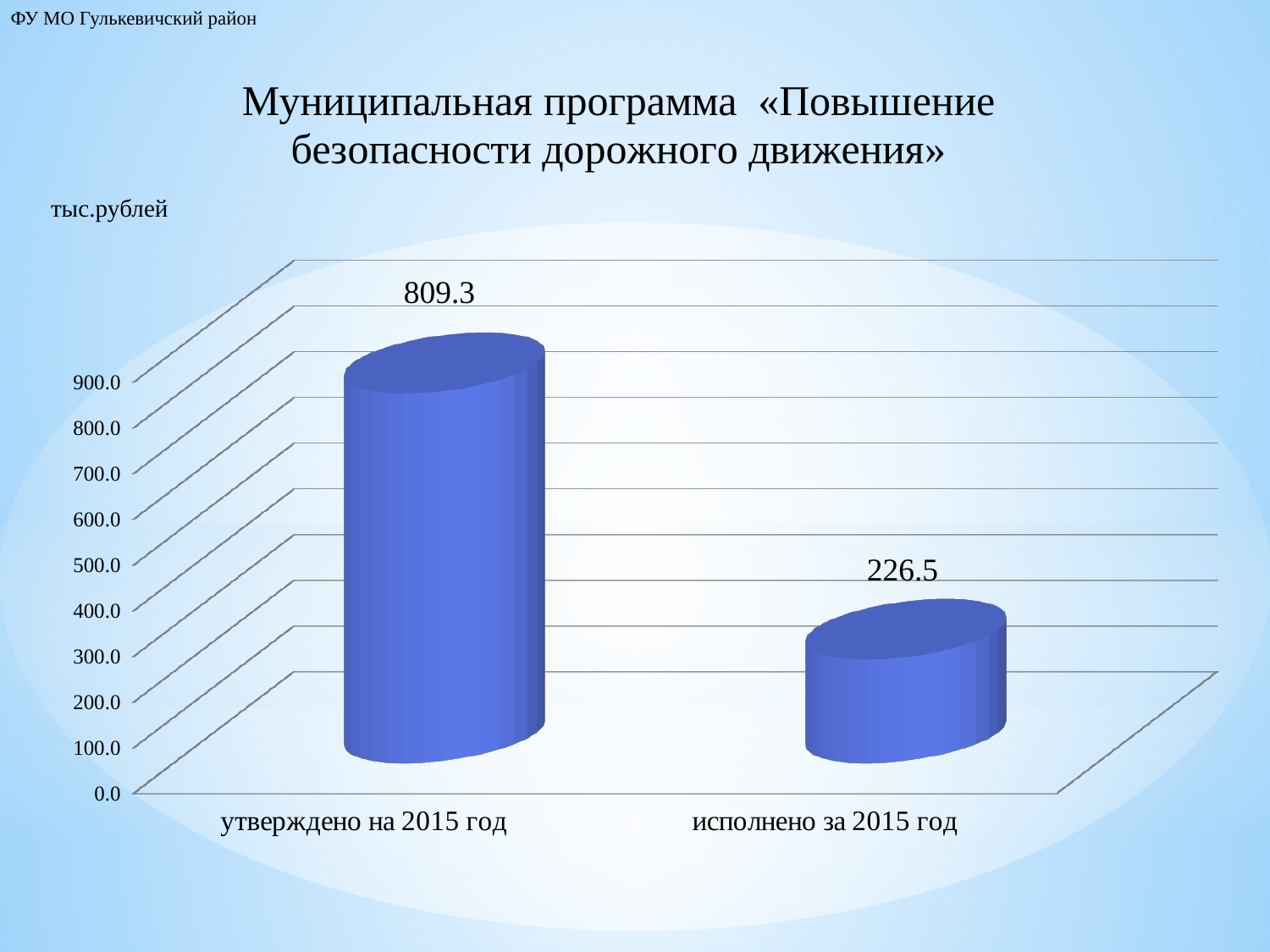
What is the highest value shown on the vertical axis? 900.0 What is the value for «исполнено за 2015 год»? 226.5 Is the value for «исполнено за 2015 год» greater or less than 300.0? less What kind of chart is shown on the slide? bar chart How many categories are shown on the chart? 2 What is the difference between the value for «утверждено на 2015 год» and the value for «исполнено за 2015 год»? 582.8 Which is larger: the value for «утверждено на 2015 год» or the value for «исполнено за 2015 год»? утверждено на 2015 год What unit is indicated above the chart? тыс.рублей Is the value for «утверждено на 2015 год» greater or less than 700.0? greater What is the value for «утверждено на 2015 год»? 809.3 Which category has the lowest value? исполнено за 2015 год Which category has the highest value? утверждено на 2015 год